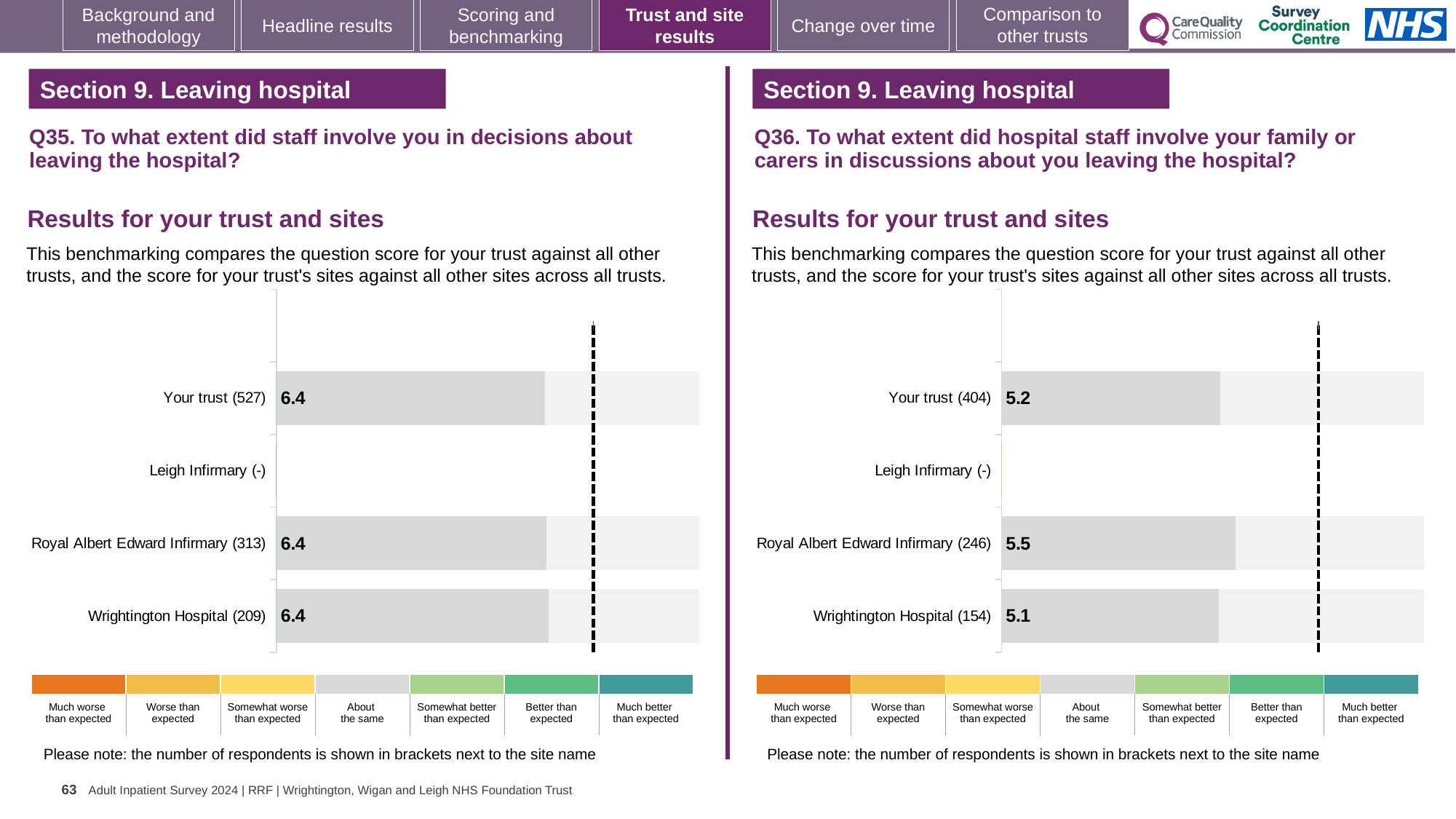
In the Q36 chart on the right, how many respondents are shown in brackets for Your trust? 404 What kind of chart is the Q35 chart on the left? Bar chart In the Q36 chart on the right, which site has the highest score? Royal Albert Edward Infirmary In the Q35 chart on the left, how many categories are listed on the vertical axis? 4 In the Q35 chart on the left, how many respondents are shown in brackets for Royal Albert Edward Infirmary? 313 In the Q36 chart on the right, what is the score for Your trust? 5.2 In the Q36 chart on the right, which labelled bar has the lowest score? Wrightington Hospital In the Q36 chart on the right, which has the larger score: Your trust or Royal Albert Edward Infirmary? Royal Albert Edward Infirmary In the Q36 chart on the right, what is the score for Royal Albert Edward Infirmary? 5.5 In the Q36 chart on the right, what is the score for Wrightington Hospital? 5.1 In the Q35 chart on the left, what is the score for Your trust? 6.4 In the Q36 chart on the right, what is the difference between the scores for Royal Albert Edward Infirmary and Wrightington Hospital? 0.4